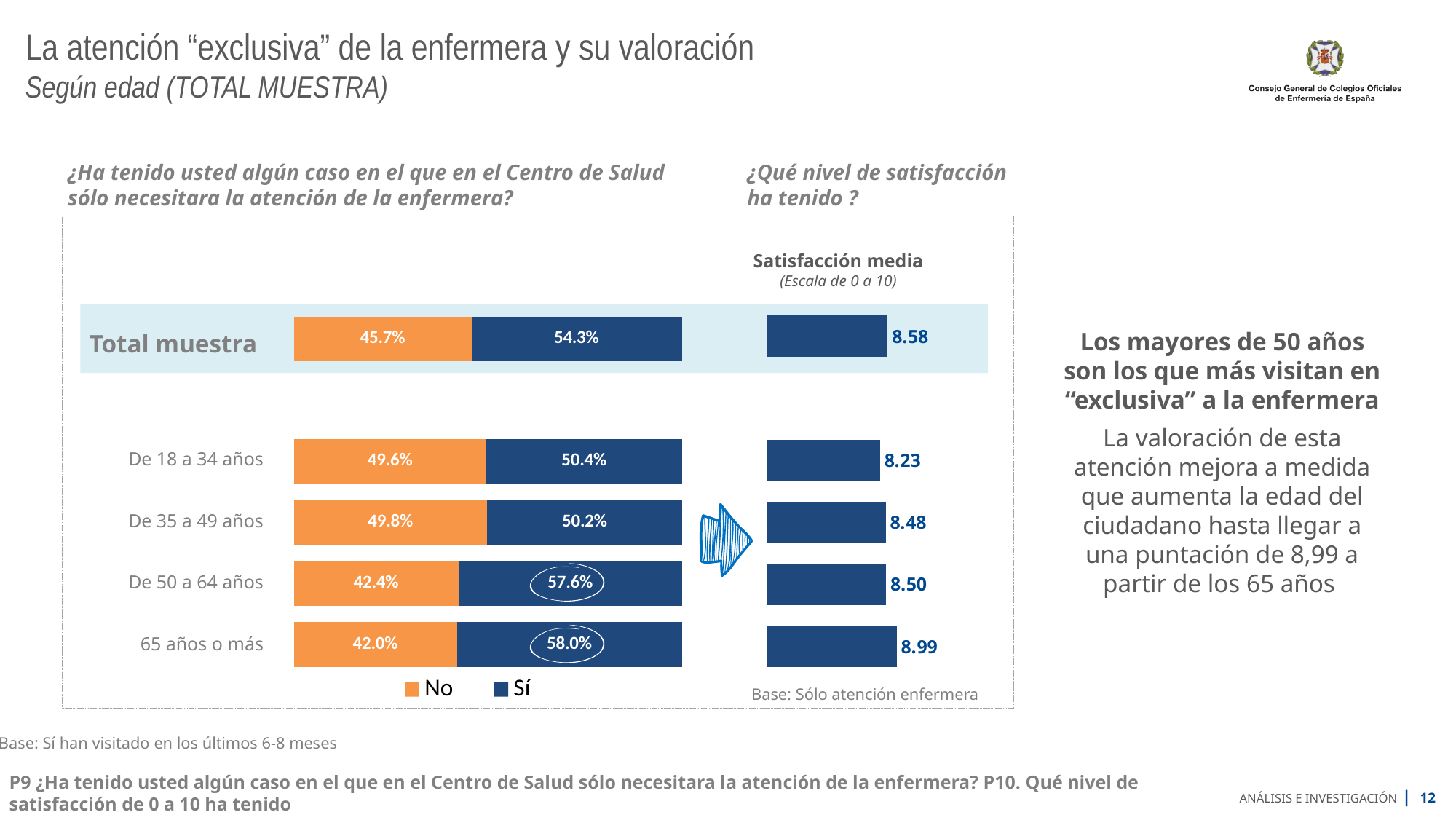
In the left stacked bar chart, which has a larger 'Sí' percentage: 'De 50 a 64 años' or 'De 18 a 34 años'? De 50 a 64 años In the 'Satisfacción media' chart, what is the value for 'De 35 a 49 años'? 8.48 In the left stacked bar chart, what is the difference between the 'Sí' and 'No' percentages for 'Total muestra'? 8.6 percentage points What kind of chart is the left chart showing 'No' and 'Sí' percentages? Stacked bar chart In the left stacked bar chart, how many age groups are shown below 'Total muestra'? 4 In the 'Satisfacción media' chart, do the values rise or fall as the age groups get older (from 'De 18 a 34 años' to '65 años o más')? Rise In the left stacked bar chart, what is the 'Sí' percentage for '65 años o más'? 58.0% In the left stacked bar chart, what is the 'No' percentage for 'De 18 a 34 años'? 49.6% How many series does the legend of the left stacked bar chart list? 2 In the 'Satisfacción media' chart, which age group has the lowest value? De 18 a 34 años In the 'Satisfacción media' chart, which age group has the highest value? 65 años o más In the left stacked bar chart, which colour represents 'No'? Orange